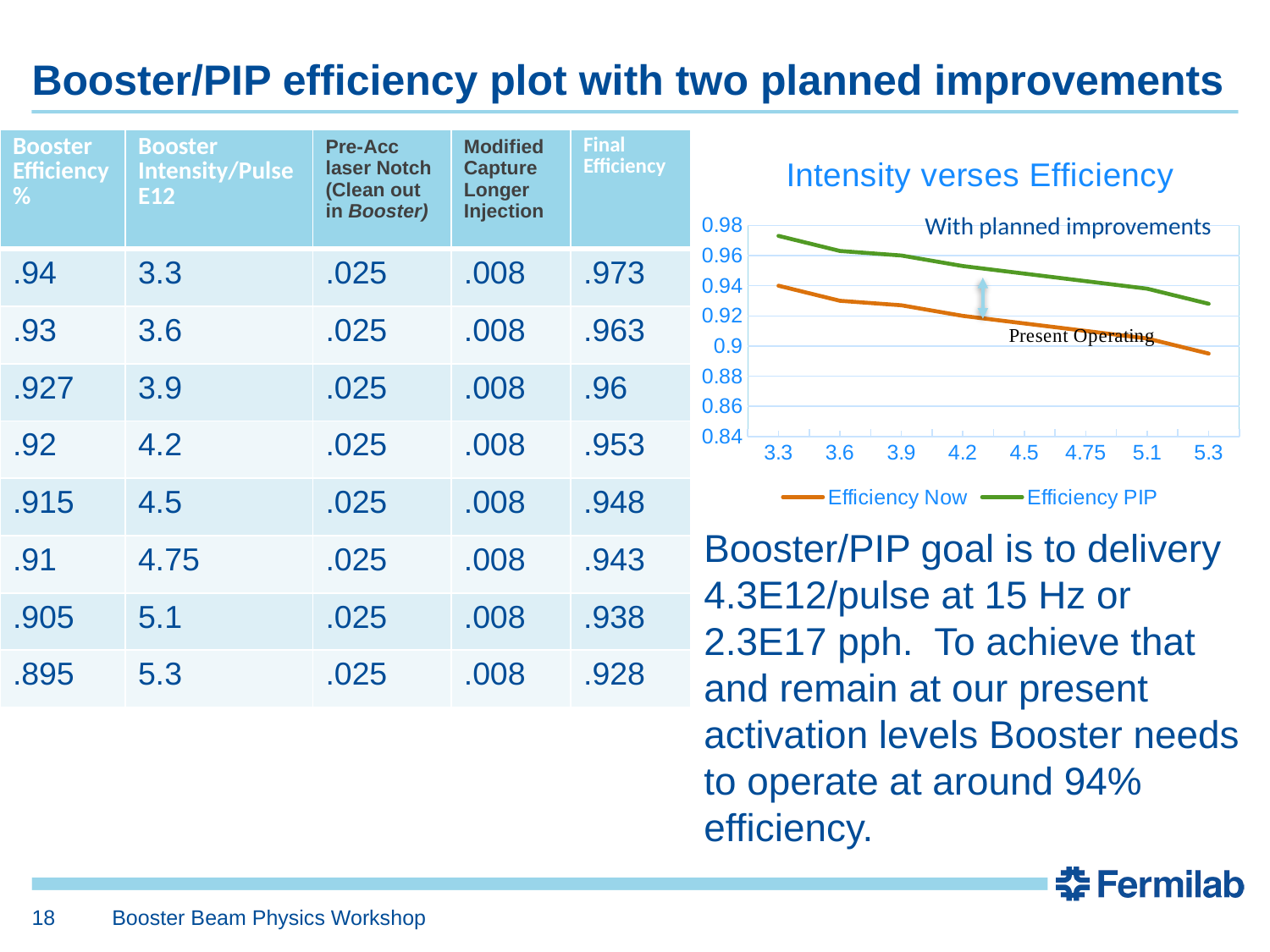
What kind of chart is shown on the slide? line chart How many series does the chart legend list? 2 Is the Efficiency PIP value at 3.3 greater or less than 0.96? greater Is the Efficiency Now value at 4.5 greater or less than 0.92? less At intensity 4.2, which series has the higher value, Efficiency Now or Efficiency PIP? Efficiency PIP Is the Efficiency PIP value at 5.3 greater or less than 0.92? greater How many intensity values are marked along the x axis of the chart? 8 Do the Efficiency Now values rise or fall as intensity increases along the x axis? fall What is the title of the chart? Intensity verses Efficiency Which series is drawn in green on the chart? Efficiency PIP At which intensity is the Efficiency PIP value lowest? 5.3